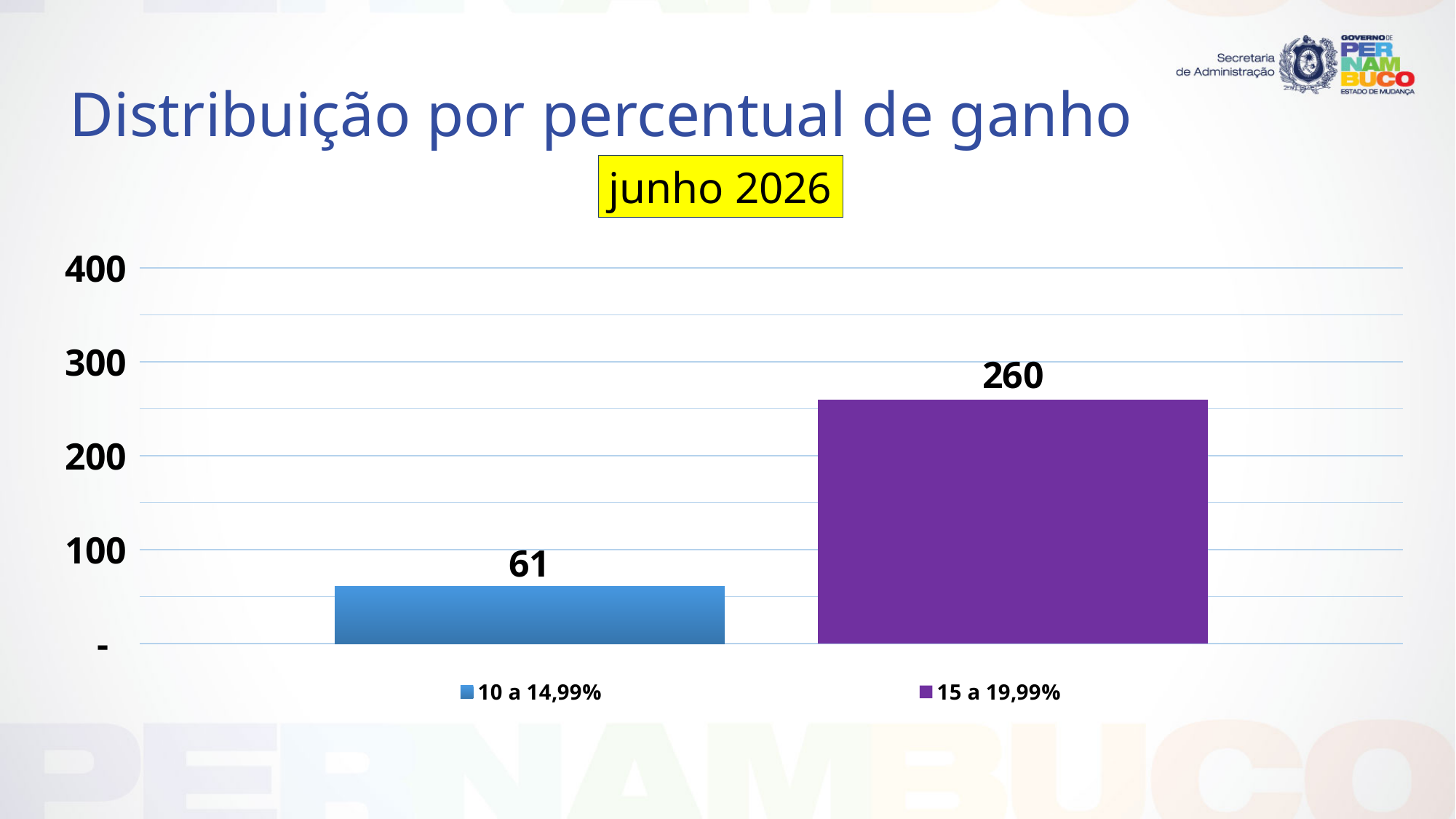
What is the value for the "10 a 14,99%" category? 61 What is the difference between the values for "15 a 19,99%" and "10 a 14,99%"? 199 How many entries does the legend list? 2 Is the value for "10 a 14,99%" greater or less than 100? less Which category has the lowest value? 10 a 14,99% Which is larger, the value for "10 a 14,99%" or the value for "15 a 19,99%"? 15 a 19,99% Is the value for "15 a 19,99%" greater or less than 200? greater What kind of chart is shown on the slide? bar chart Which category has the highest value? 15 a 19,99% What colour is the bar for "15 a 19,99%"? purple How many categories are shown in the chart? 2 What is the value for the "15 a 19,99%" category? 260